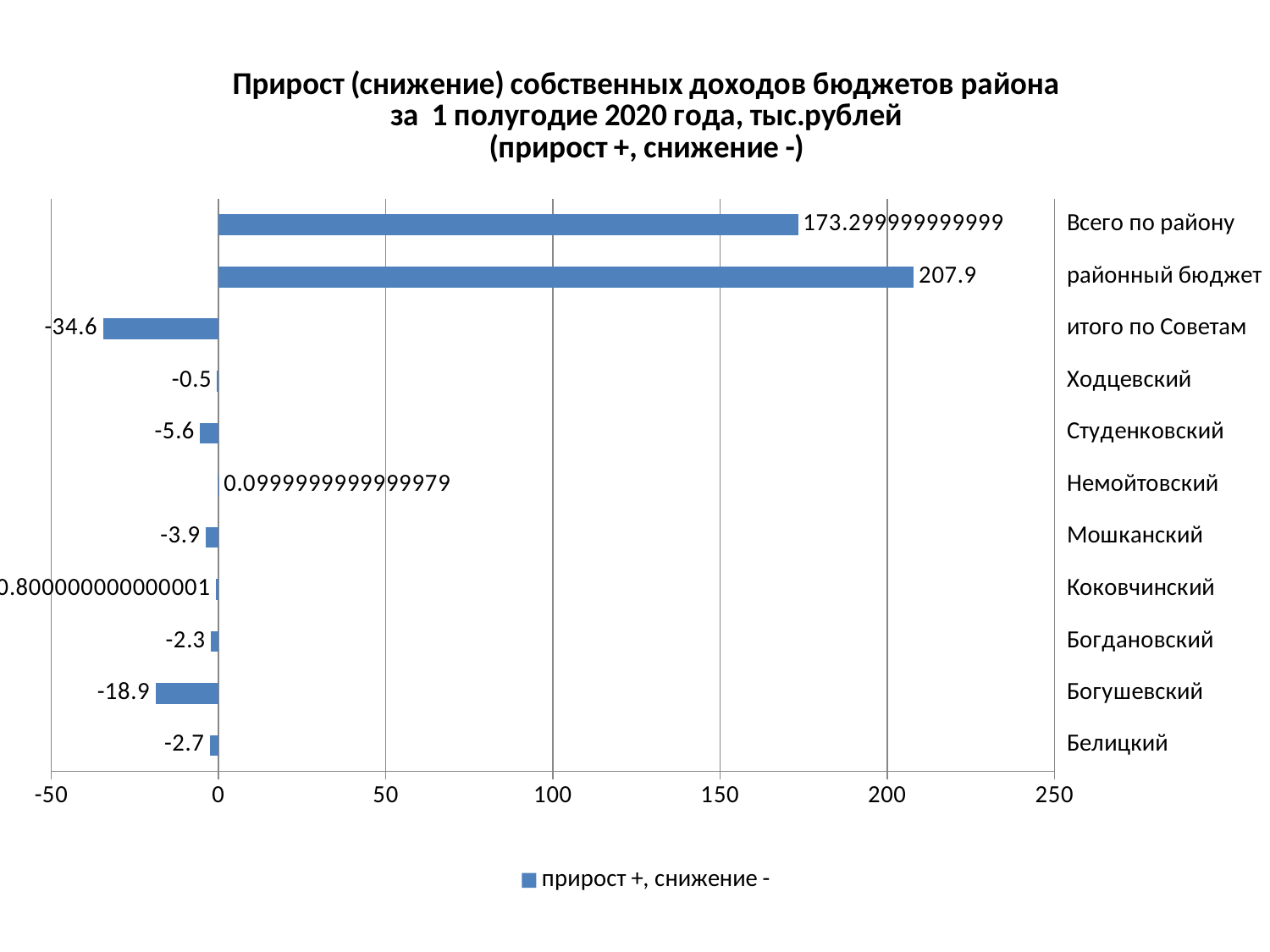
What is the difference between the values for районный бюджет and итого по Советам? 242.5 Is the value for Всего по району greater or less than 150? greater How many categories are shown on the chart? 11 What is the value for Богушевский? -18.9 Which category has the highest value? районный бюджет What kind of chart is shown on the slide? bar chart Which category has the lowest value? итого по Советам What is the value for Белицкий? -2.7 What is the value for Студенковский? -5.6 What is the value for итого по Советам? -34.6 Which is larger, the value for Богушевский or the value for Богдановский? Богдановский What is the value for районный бюджет? 207.9